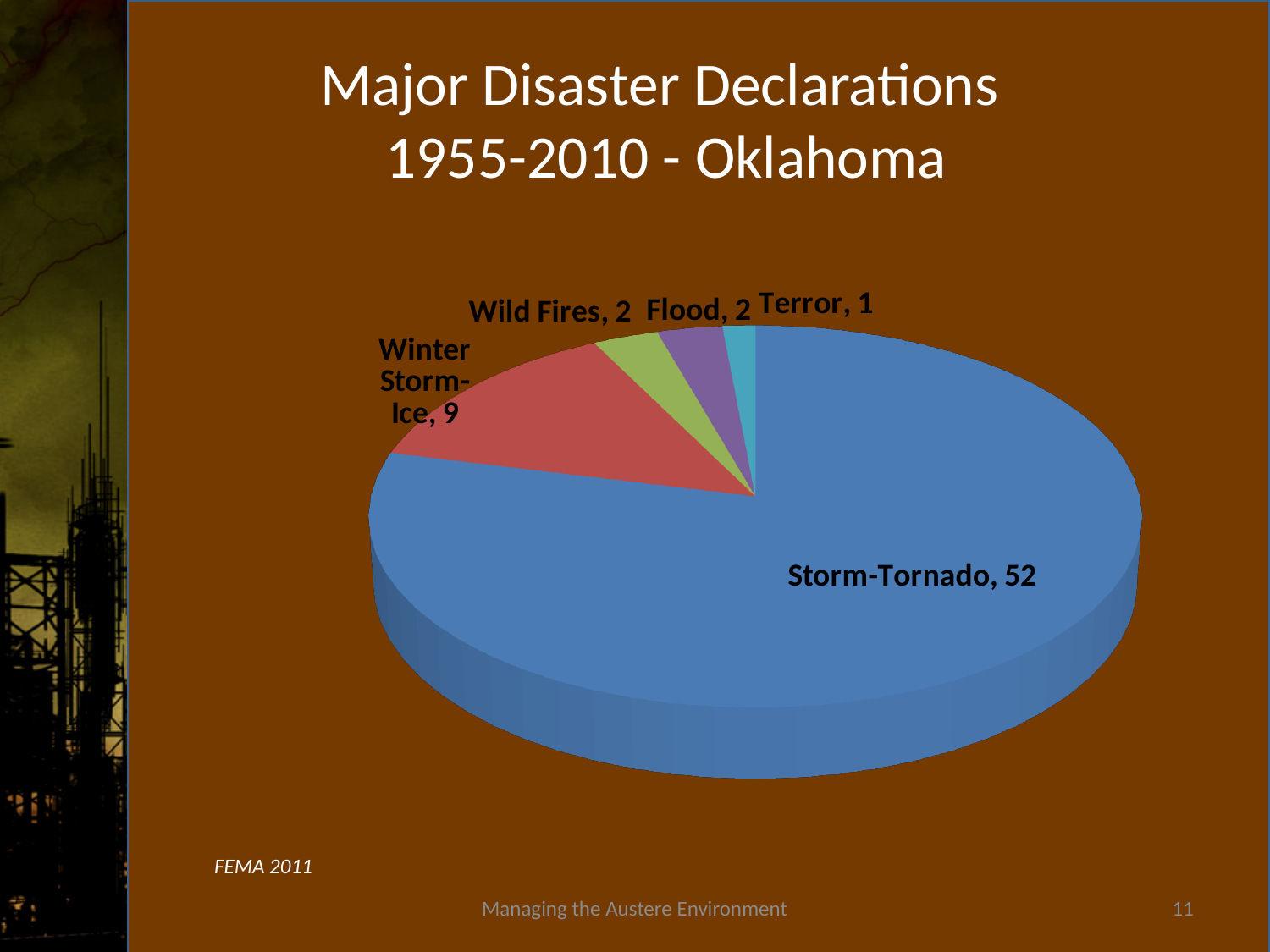
What is the value for Winter Storm-Ice in the pie chart? 9 Which category has the smallest slice of the pie? Terror What is the title of the slide containing the pie chart? Major Disaster Declarations 1955-2010 - Oklahoma How many major disaster declarations are shown for Storm-Tornado? 52 How many categories are shown in the pie chart? 5 What is the total of all the values shown in the pie chart? 66 Which is larger, the value for Winter Storm-Ice or the value for Flood? Winter Storm-Ice What is the value for Wild Fires in the pie chart? 2 What is the difference between the Storm-Tornado value and the Winter Storm-Ice value? 43 What type of chart is shown on the slide? Pie chart Which category has the largest slice of the pie? Storm-Tornado What is the value for Terror in the pie chart? 1